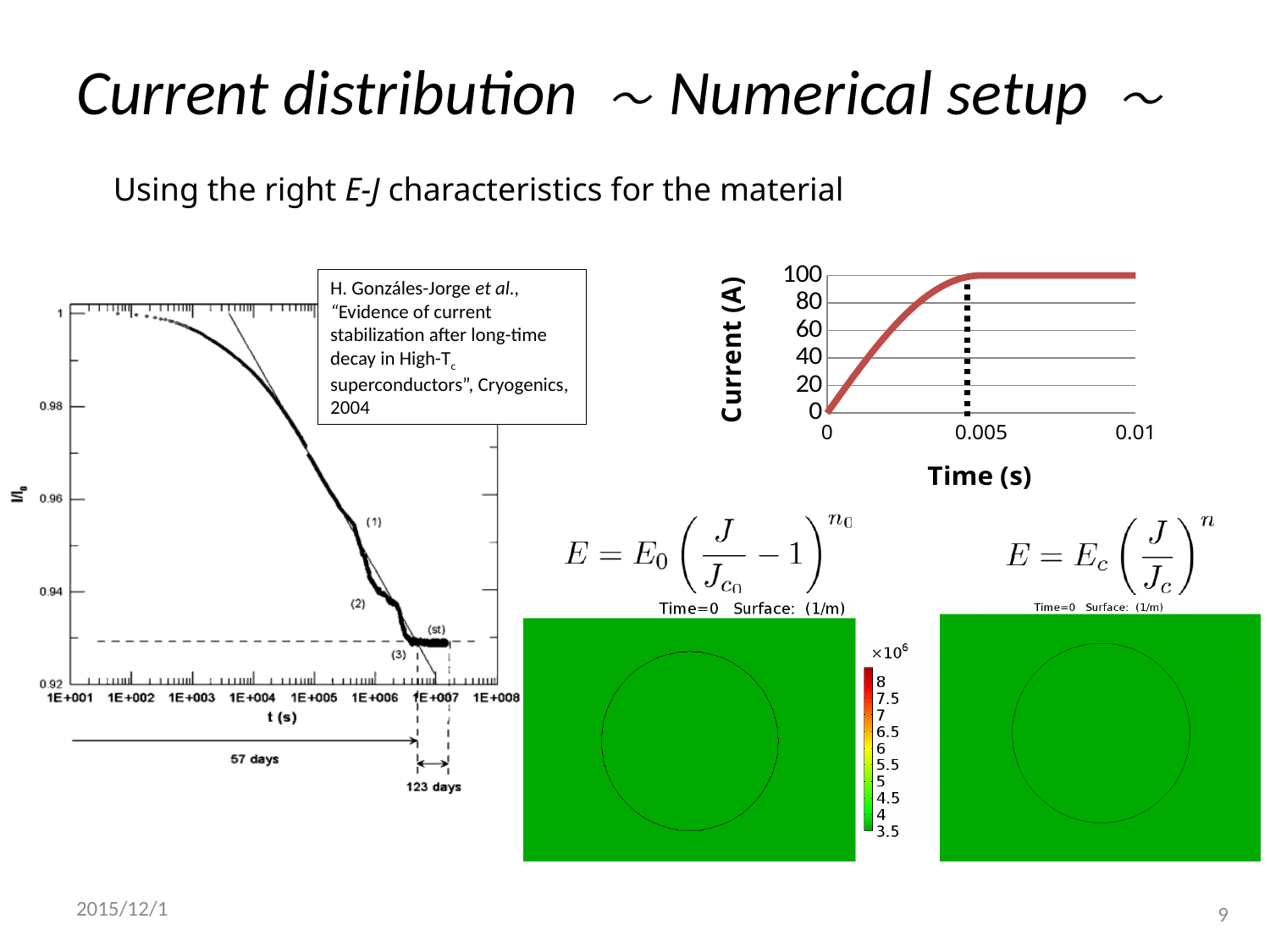
In the Current (A) versus Time (s) chart, what is the label of the vertical axis? Current (A) In the I/I0 versus t (s) chart on the left, does I/I0 rise or fall as t increases? fall In the I/I0 versus t (s) chart on the left, is the value of I/I0 at t = 1E+007 greater or less than 0.94? less In the Current (A) versus Time (s) chart, what is the highest value shown on the vertical axis? 100 In the I/I0 versus t (s) chart on the left, what is the lowest value shown on the vertical axis? 0.92 In the Current (A) versus Time (s) chart, what is the current at time 0? 0 In the Current (A) versus Time (s) chart, is the current at time 0.01 greater or less than 80? greater In the Current (A) versus Time (s) chart, does the current rise or fall as time increases from 0 to 0.005? rise In the Current (A) versus Time (s) chart, what current value does the curve level off at? 100 What kind of chart is the Current (A) versus Time (s) chart at the top right? line chart In the Current (A) versus Time (s) chart, is the current at time 0.005 greater or less than 60? greater